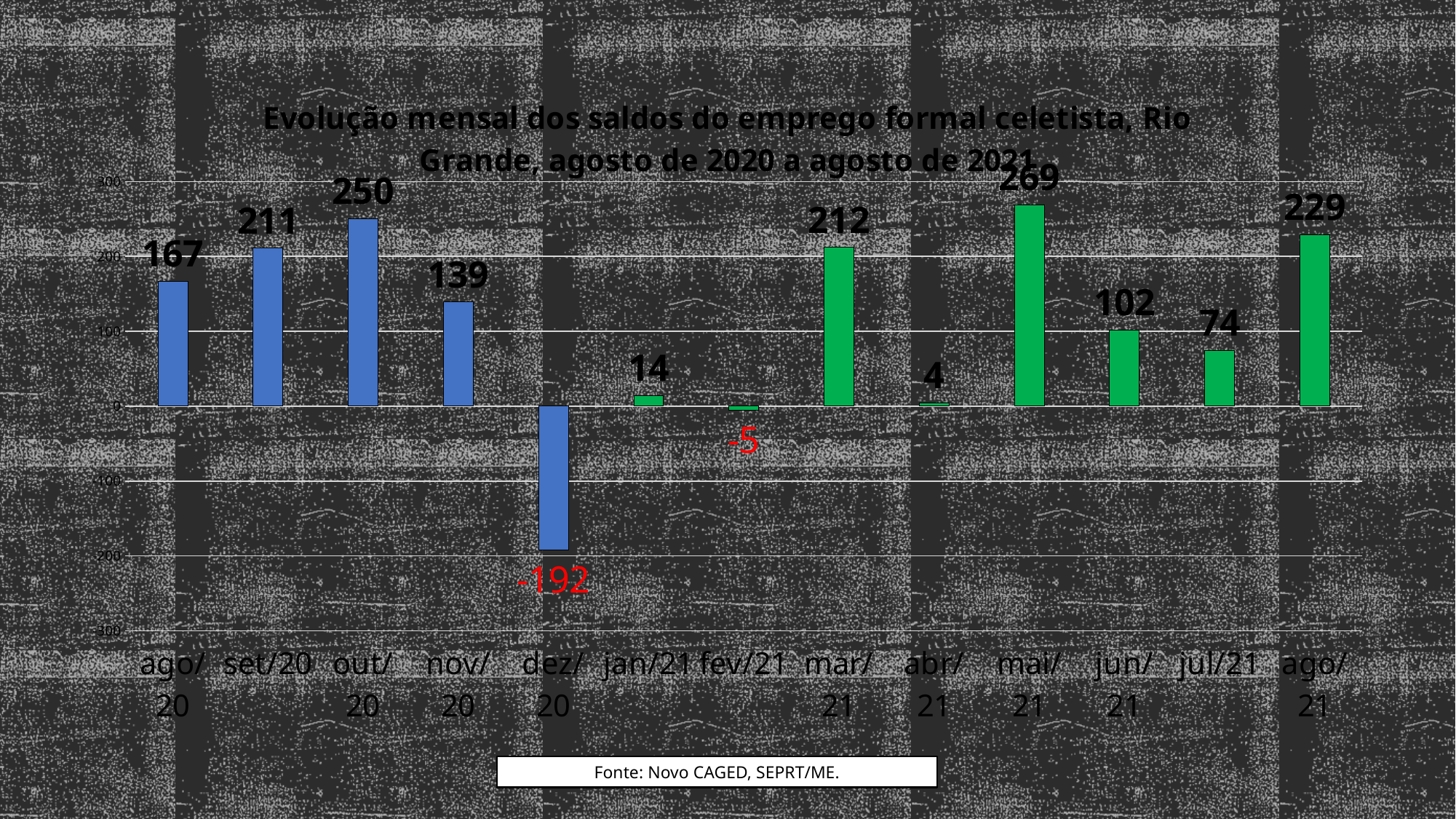
How many months are shown on the x axis? 13 What is the difference between the values for mai/21 and ago/21? 40 What source is cited below the chart? Novo CAGED, SEPRT/ME. What is the value for fev/21? -5 Which is larger, the value for set/20 or the value for mar/21? mar/21 What is the value for dez/20? -192 What is the value for out/20? 250 Which month has the highest value? mai/21 Do the values rise or fall from ago/20 to out/20? rise What is the value for mar/21? 212 Which month has the lowest value? dez/20 What kind of chart is shown on the slide? bar chart